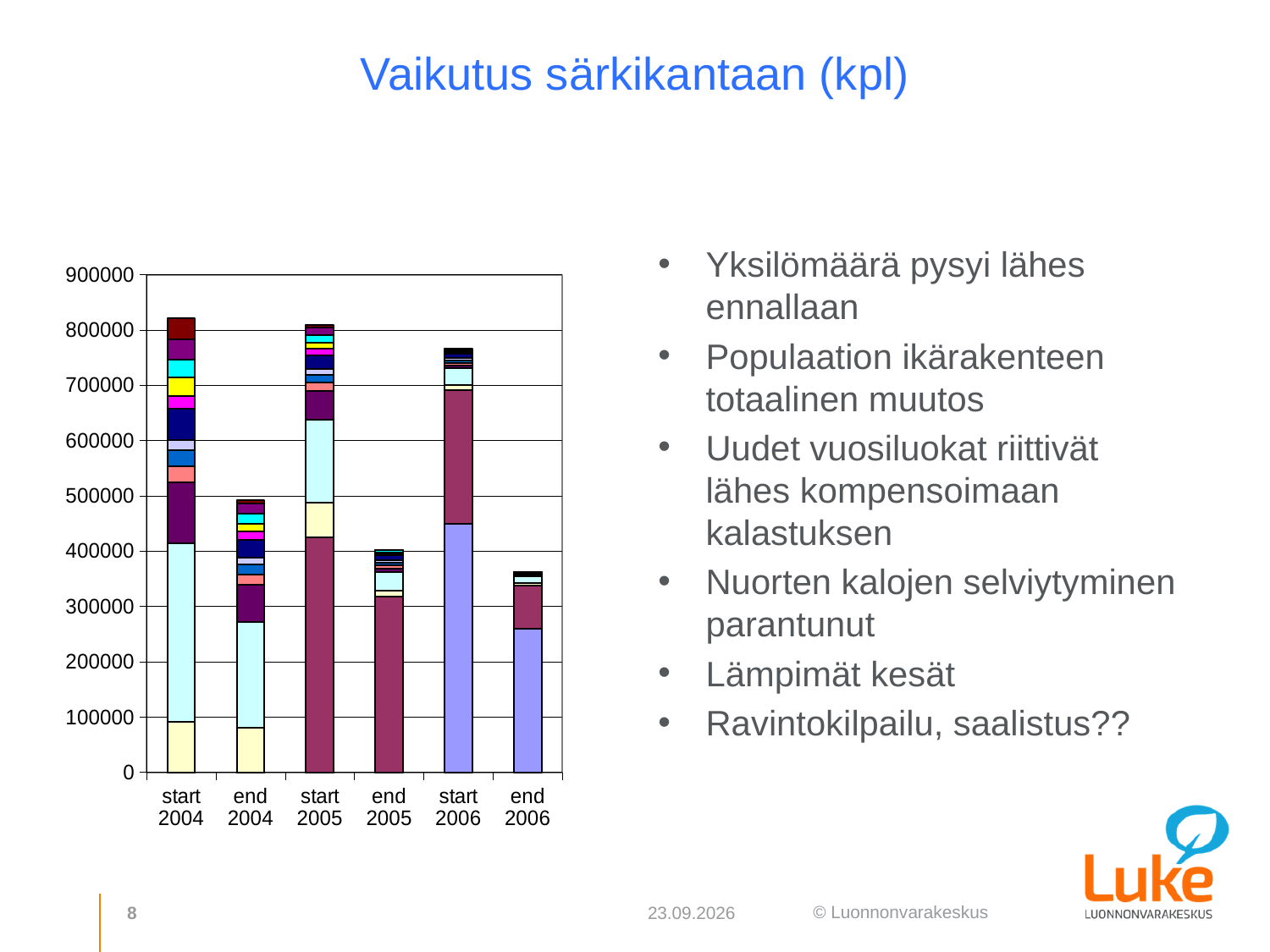
What is the title of the slide containing the chart? Vaikutus särkikantaan (kpl) Is the total value of the bar for end 2004 greater or less than 400000? greater How many categories are shown on the x axis of the chart? 6 Which bar has the lowest total, end 2005 or end 2006? end 2006 Is the total value of the bar for end 2006 greater or less than 400000? less What kind of chart is shown on the slide? stacked bar chart Within each year, does the total rise or fall from start to end? fall Is the total value of the bar for start 2006 greater or less than 700000? greater Which bar is taller, start 2004 or end 2004? start 2004 Which bar is taller, start 2006 or end 2006? start 2006